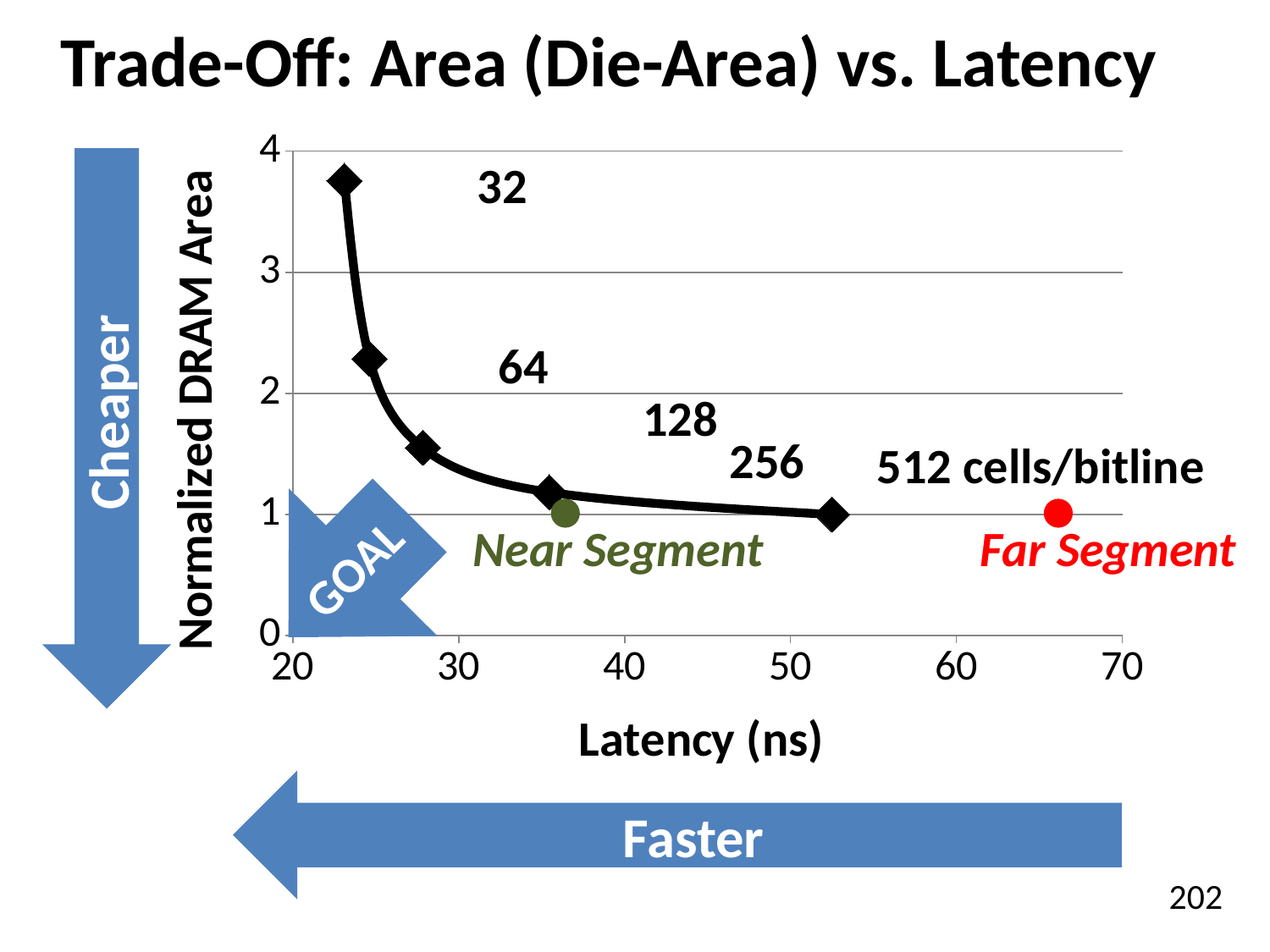
How many black diamond data points are plotted on the curve? 5 Which cells/bitline configuration has the lowest latency? 32 Which cells/bitline configuration has the highest normalized DRAM area? 32 Is the normalized DRAM area for 128 cells/bitline greater or less than 2? less Is the normalized DRAM area for 32 cells/bitline greater or less than 3? greater Is the latency of the Near Segment point greater or less than 40 ns? less Which has a larger normalized DRAM area, 64 cells/bitline or 128 cells/bitline? 64 cells/bitline Which cells/bitline configuration has the highest latency on the black curve? 512 cells/bitline As latency increases along the x axis, does the normalized DRAM area rise or fall? fall What kind of chart is shown on the slide? line chart